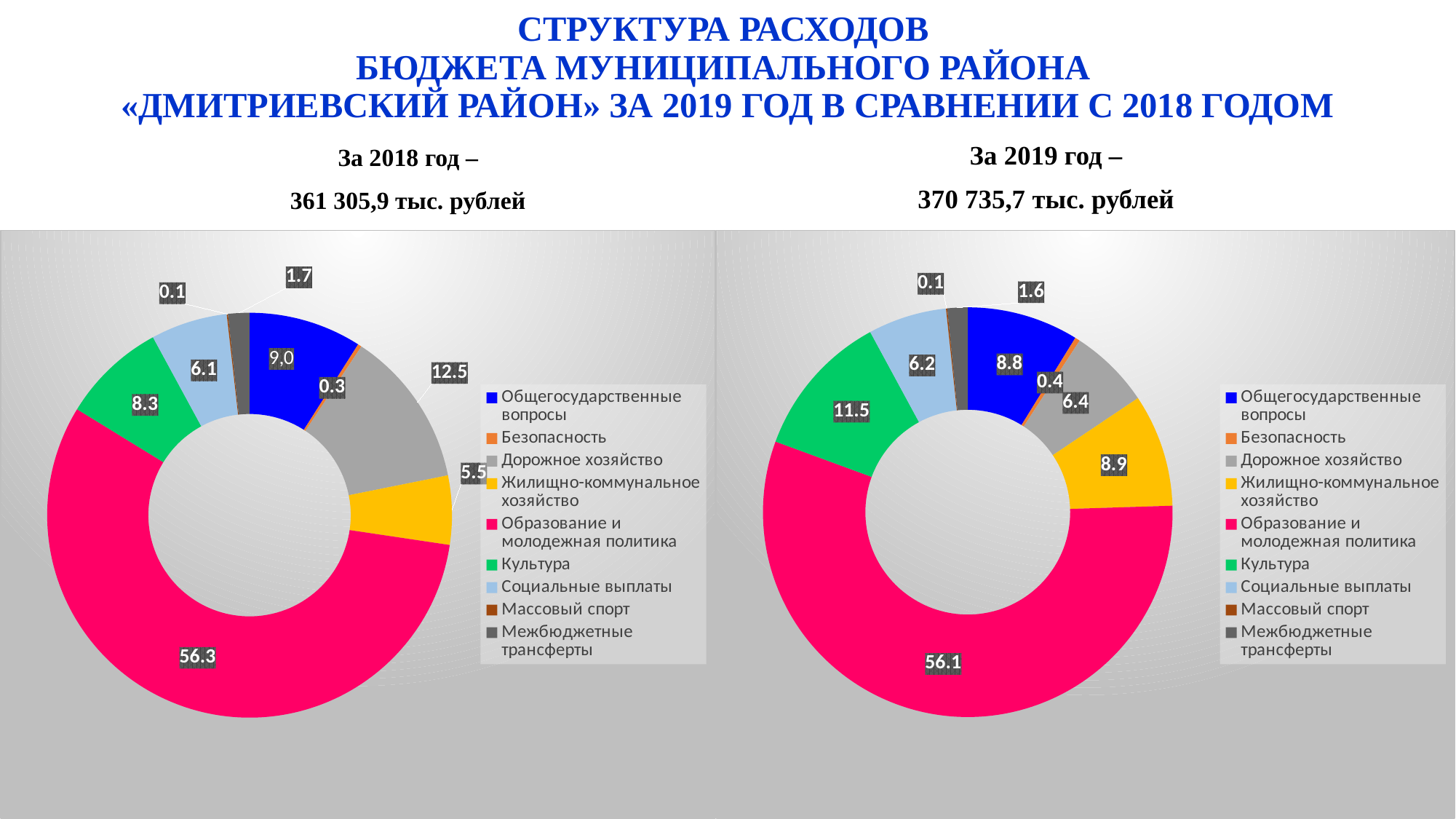
In the 2019 chart (right), which category has the largest share? Образование и молодежная политика In the 2019 chart (right), what is the value for Культура? 11.5 In the 2019 chart (right), which is larger: Общегосударственные вопросы or Жилищно-коммунальное хозяйство? Жилищно-коммунальное хозяйство In the 2018 chart (left), which category has the smallest share? Массовый спорт What total expenditure amount is shown above the 2019 chart (right)? 370 735,7 тыс. рублей In the 2019 chart (right), what is the value for Жилищно-коммунальное хозяйство? 8.9 What is the difference between the Культура value in the 2019 chart (11.5) and in the 2018 chart (8.3)? 3.2 What is the difference between the Дорожное хозяйство value in the 2018 chart (12.5) and in the 2019 chart (6.4)? 6.1 In the 2018 chart (left), what is the value for Дорожное хозяйство? 12.5 What type of chart is used on this slide for the 2018 and 2019 budget structures? Doughnut (pie) chart How many categories does the legend of the 2018 chart (left) list? 9 In the 2018 chart (left), what is the value for Образование и молодежная политика? 56.3